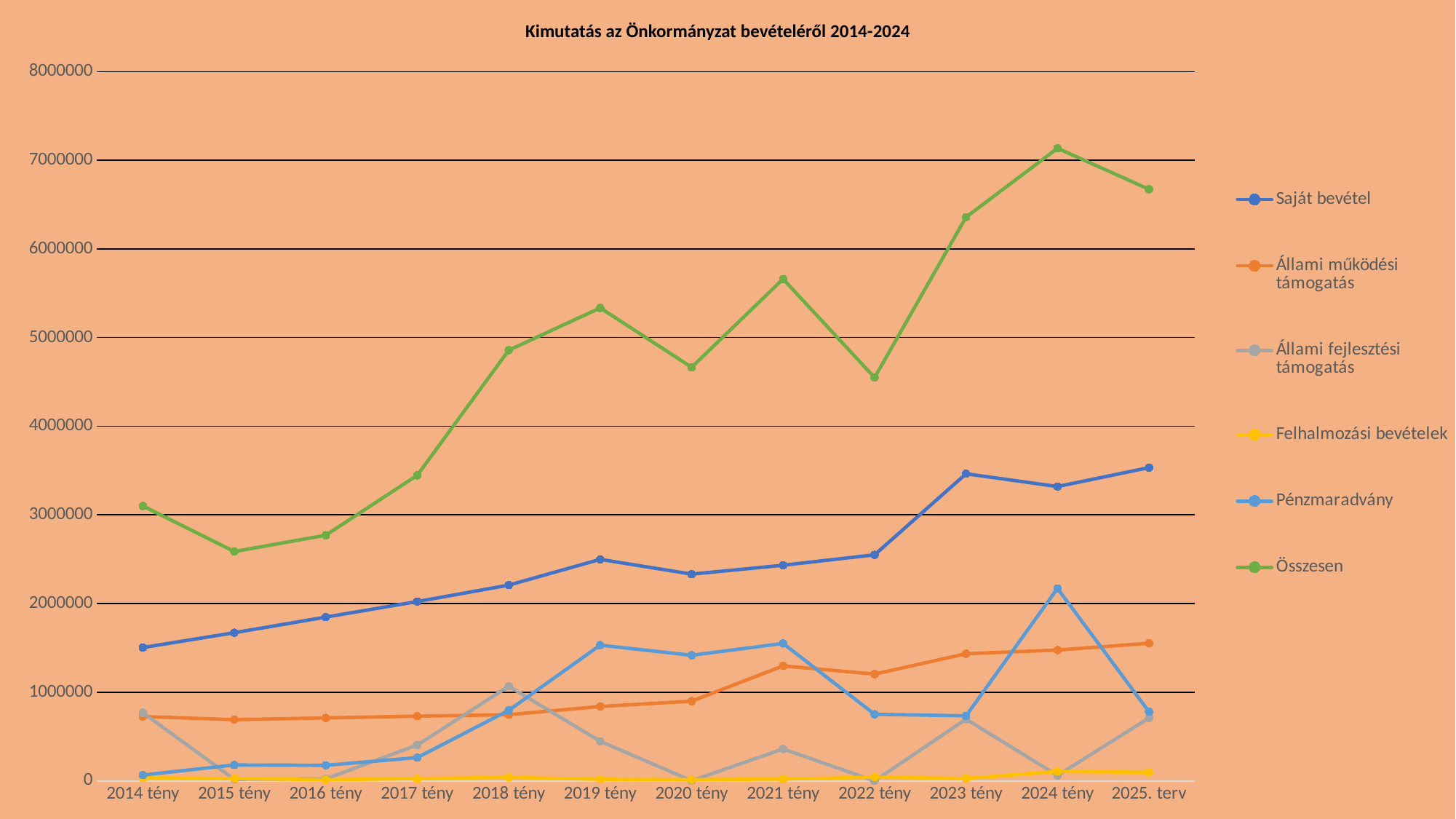
Is the value of Összesen for 2023 tény greater or less than 6000000? greater In which year is the Saját bevétel series at its lowest? 2014 tény Which colour is used for the Összesen series? green What is the title of the chart? Kimutatás az Önkormányzat bevételéről 2014-2024 Does the Saját bevétel series rise or fall from 2014 tény to 2019 tény? rise How many points are there along the x axis? 12 Is the value of Saját bevétel for 2014 tény greater or less than 2000000? less What kind of chart is shown on the slide? line chart How many series does the legend list? 6 In which year does the Pénzmaradvány series reach its highest value? 2024 tény For 2020 tény, which is larger: Saját bevétel or Állami működési támogatás? Saját bevétel In which year does the Összesen series reach its highest value? 2024 tény